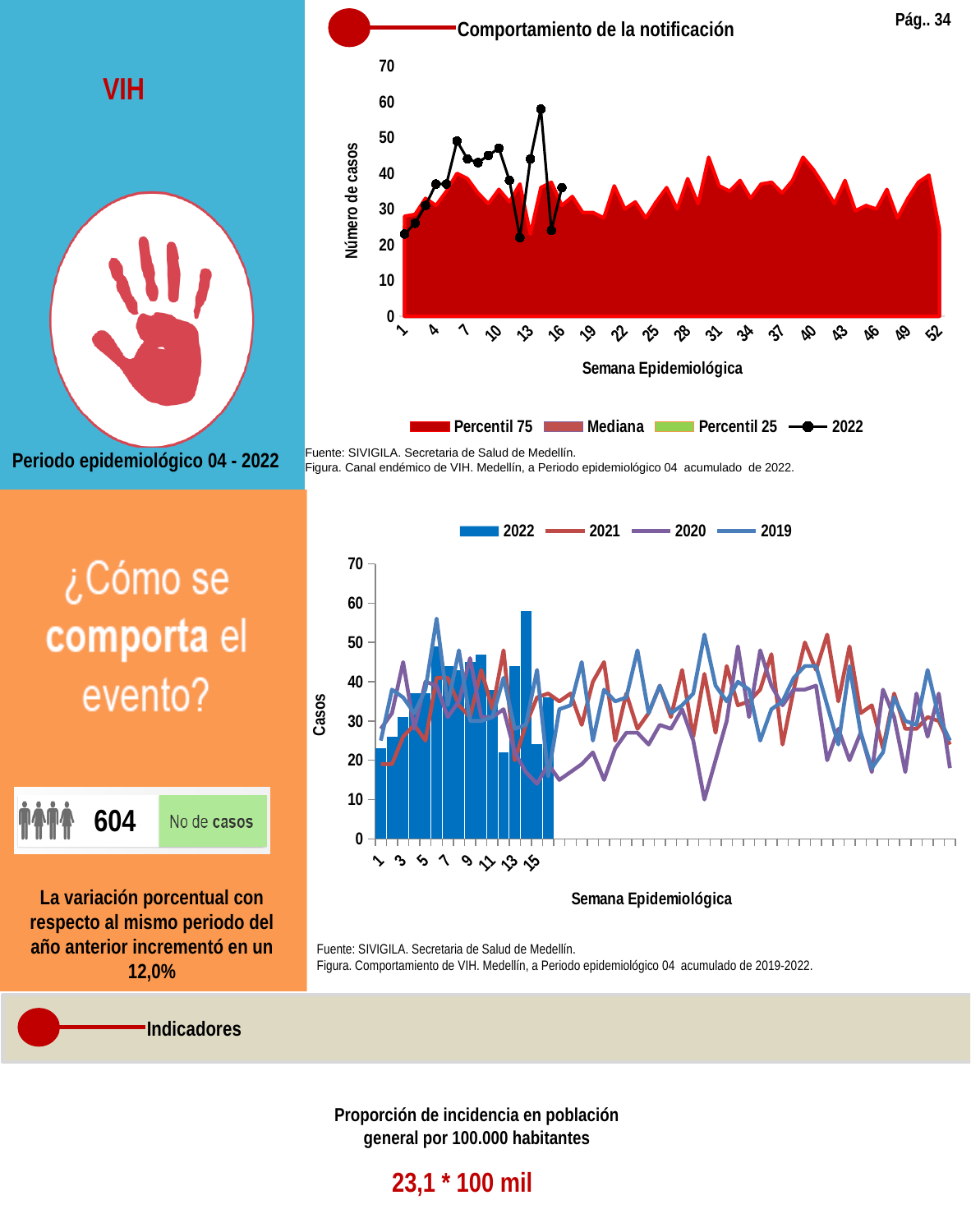
In the top chart 'Comportamiento de la notificación', what is the title of the vertical axis? Número de casos In the bottom chart (Comportamiento de VIH 2019-2022), at which epidemiological week is the 2022 bar the tallest? 14 In the bottom chart (Comportamiento de VIH 2019-2022), is the 2022 bar at week 15 greater or less than 30? less In the top chart 'Comportamiento de la notificación', how many series does the legend list? 4 In the top chart 'Comportamiento de la notificación', which series is drawn as a black line with markers? 2022 In the bottom chart (Comportamiento de VIH 2019-2022), what is the title of the horizontal axis? Semana Epidemiológica In the top chart 'Comportamiento de la notificación', is the 2022 value at week 1 greater or less than 30? less In the bottom chart (Comportamiento de VIH 2019-2022), how many series does the legend list? 4 In the bottom chart (Comportamiento de VIH 2019-2022), which series is plotted as bars? 2022 In the bottom chart (Comportamiento de VIH 2019-2022), is the 2022 bar at week 14 greater or less than 50? greater In the top chart 'Comportamiento de la notificación', at which epidemiological week does the 2022 line reach its highest point? 14